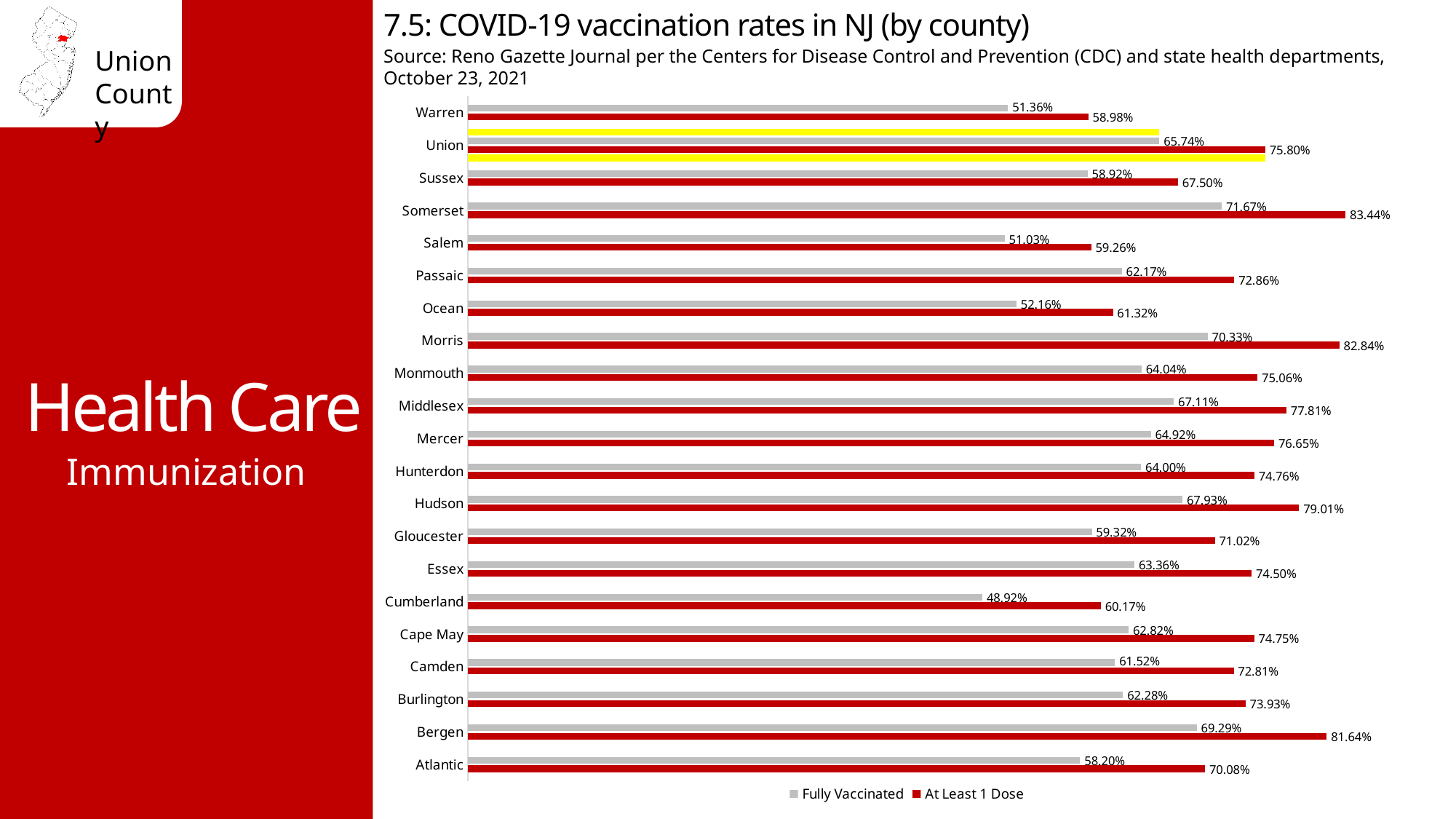
Which county has the lowest At Least 1 Dose rate? Warren What type of chart is shown on the slide? Bar chart How many counties are shown in the chart? 21 Which county has the lowest Fully Vaccinated rate? Cumberland How many series does the legend list? 2 What is the Fully Vaccinated rate for Union county? 65.74% Which county has a higher Fully Vaccinated rate, Bergen or Hudson? Bergen What is the At Least 1 Dose rate for Cumberland county? 60.17% What is the difference between the At Least 1 Dose rate and the Fully Vaccinated rate for Union county? 10.06 percentage points What is the At Least 1 Dose rate for Somerset county? 83.44% Which county has the highest Fully Vaccinated rate? Somerset Which county's bars are highlighted in yellow on the chart? Union